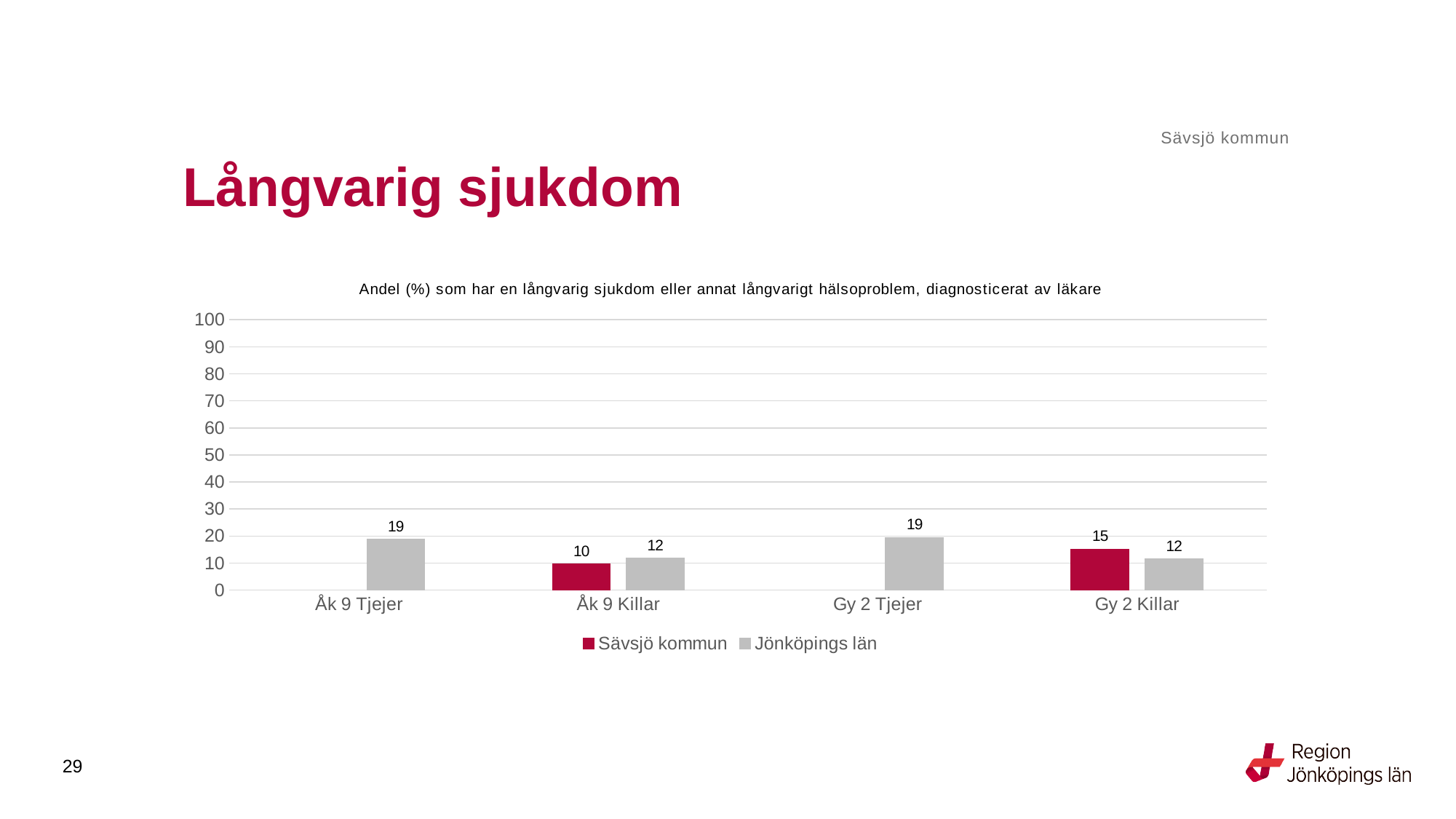
Is the value for Jönköpings län for Gy 2 Tjejer greater or less than 30? less What kind of chart is shown on the slide? Bar chart What is the value for Jönköpings län for Gy 2 Killar? 12 What is the value for Sävsjö kommun for Åk 9 Killar? 10 How many series does the legend list? 2 Which category has the lowest value for Jönköpings län? Åk 9 Killar and Gy 2 Killar (both 12) What is the value for Sävsjö kommun for Gy 2 Killar? 15 How many categories are shown on the x axis? 4 For Åk 9 Killar, which is larger: Sävsjö kommun or Jönköpings län? Jönköpings län Which category has the highest value for Sävsjö kommun? Gy 2 Killar What is the value for Jönköpings län for Åk 9 Tjejer? 19 What is the difference between Sävsjö kommun and Jönköpings län for Gy 2 Killar? 3